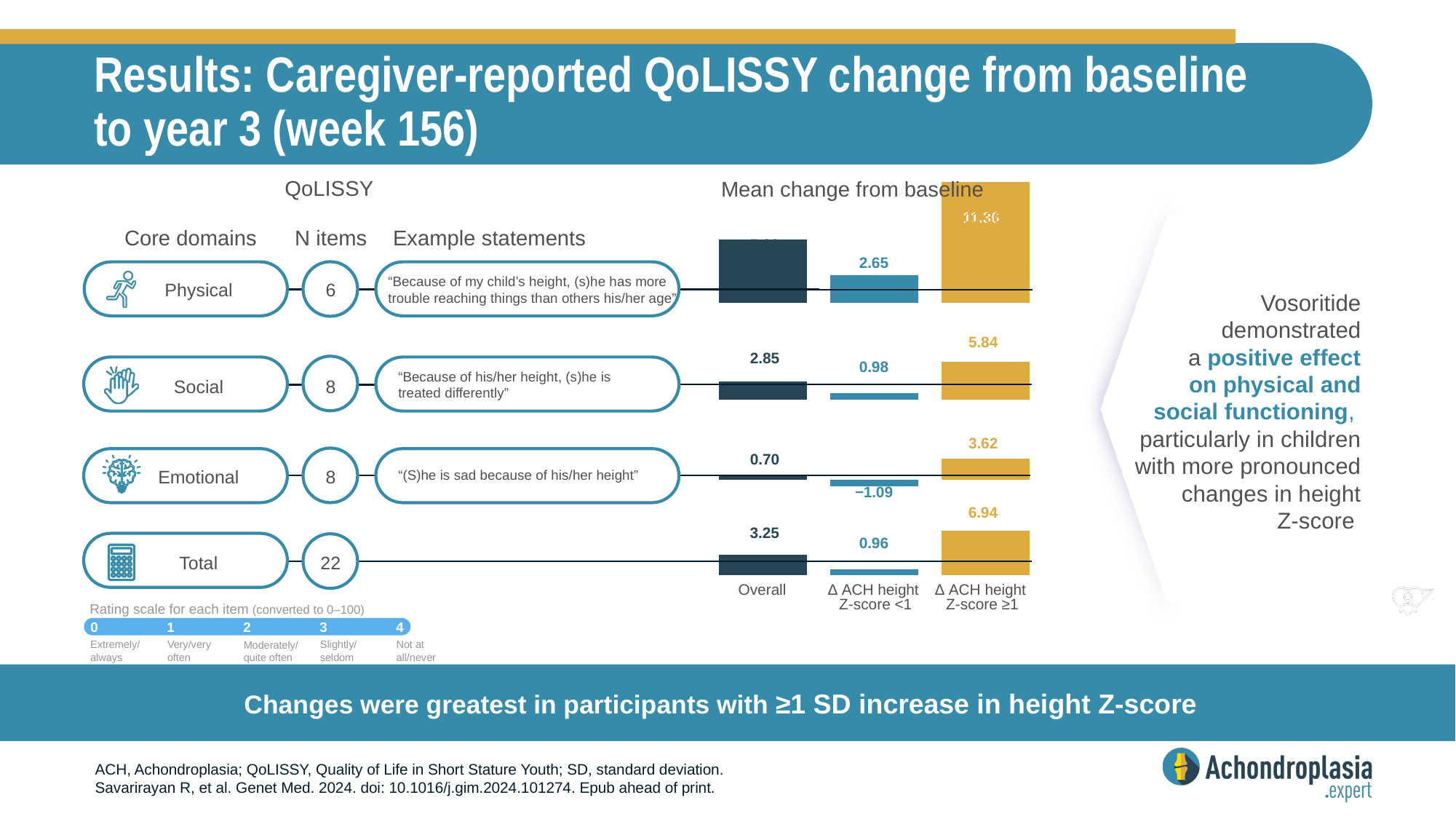
What kind of chart is used to show the mean change from baseline? Bar chart For the Emotional domain, which group shows the lowest mean change from baseline? Δ ACH height Z-score <1 For the Social domain, which group shows the highest mean change from baseline? Δ ACH height Z-score ≥1 What is the mean change from baseline for the Physical domain in the Δ ACH height Z-score <1 group? 2.65 How many groups (series) are shown for each domain in the mean change from baseline chart? 3 For the Social domain, what is the difference between the Δ ACH height Z-score ≥1 group (5.84) and the Overall group (2.85)? 2.99 How many QoLISSY domains (rows) are plotted in the mean change from baseline chart? 4 In the Overall group, which is larger: the mean change for Social or for Total? Total What is the mean change from baseline for the Total score in the Δ ACH height Z-score ≥1 group? 6.94 What is the mean change from baseline for the Emotional domain in the Δ ACH height Z-score <1 group? −1.09 What is the mean change from baseline for the Social domain in the Overall group? 2.85 For the Total score, what is the difference between the Δ ACH height Z-score ≥1 group (6.94) and the Δ ACH height Z-score <1 group (0.96)? 5.98